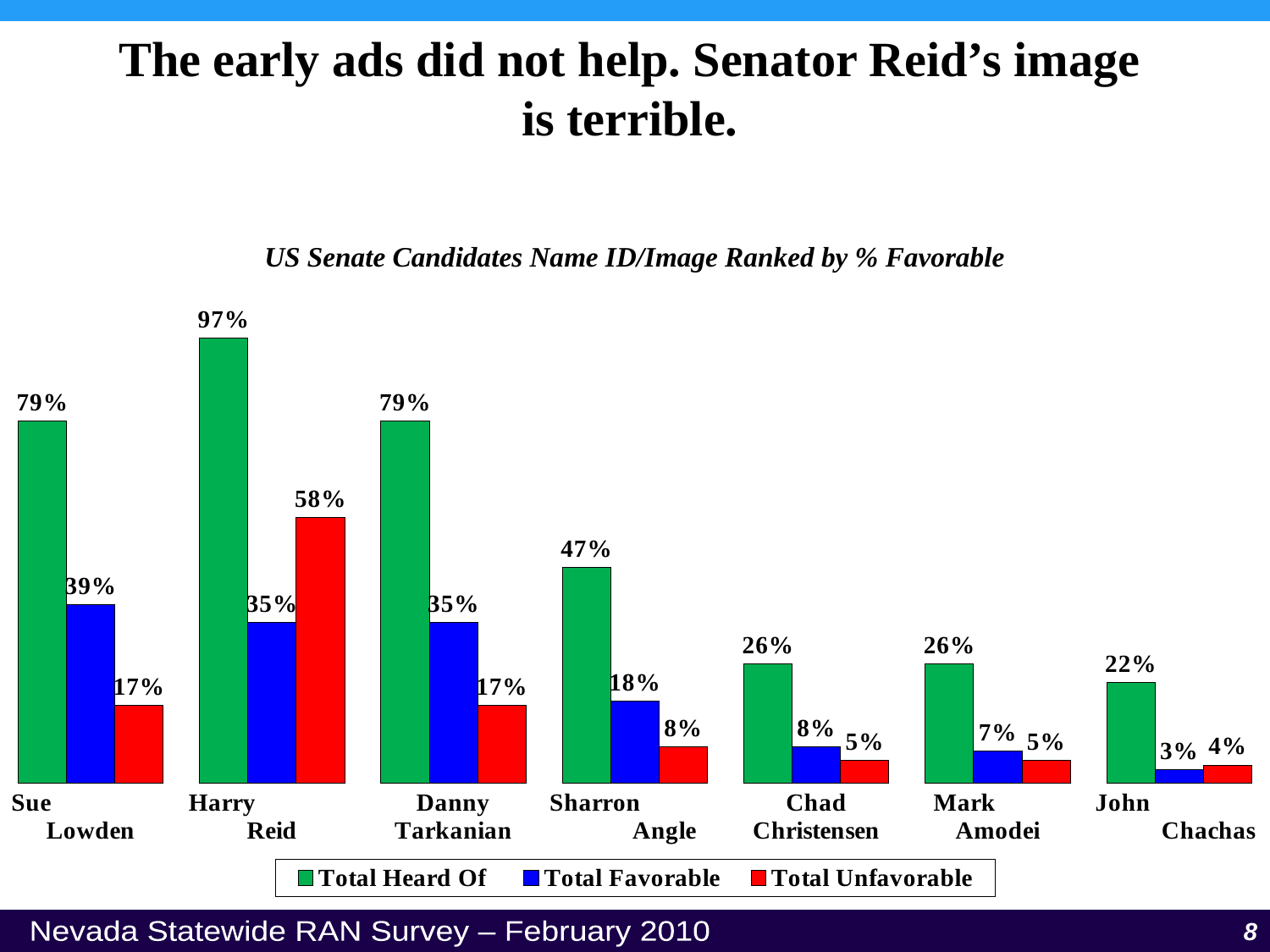
Which candidate has the highest Total Heard Of value? Harry Reid What is the Total Heard Of value for Harry Reid? 97% What is the Total Favorable value for Sue Lowden? 39% What is the title of the chart? US Senate Candidates Name ID/Image Ranked by % Favorable What is the Total Unfavorable value for Harry Reid? 58% How many series does the legend list? 3 Which colour represents Total Unfavorable in the legend? Red How many candidates are shown on the chart? 7 Which is larger: Sharron Angle's Total Heard Of or Danny Tarkanian's Total Heard Of? Danny Tarkanian's Total Heard Of What kind of chart is shown on the slide? Bar chart Which candidate has the lowest Total Favorable value? John Chachas What is the difference between Harry Reid's Total Unfavorable and Total Favorable values? 23%